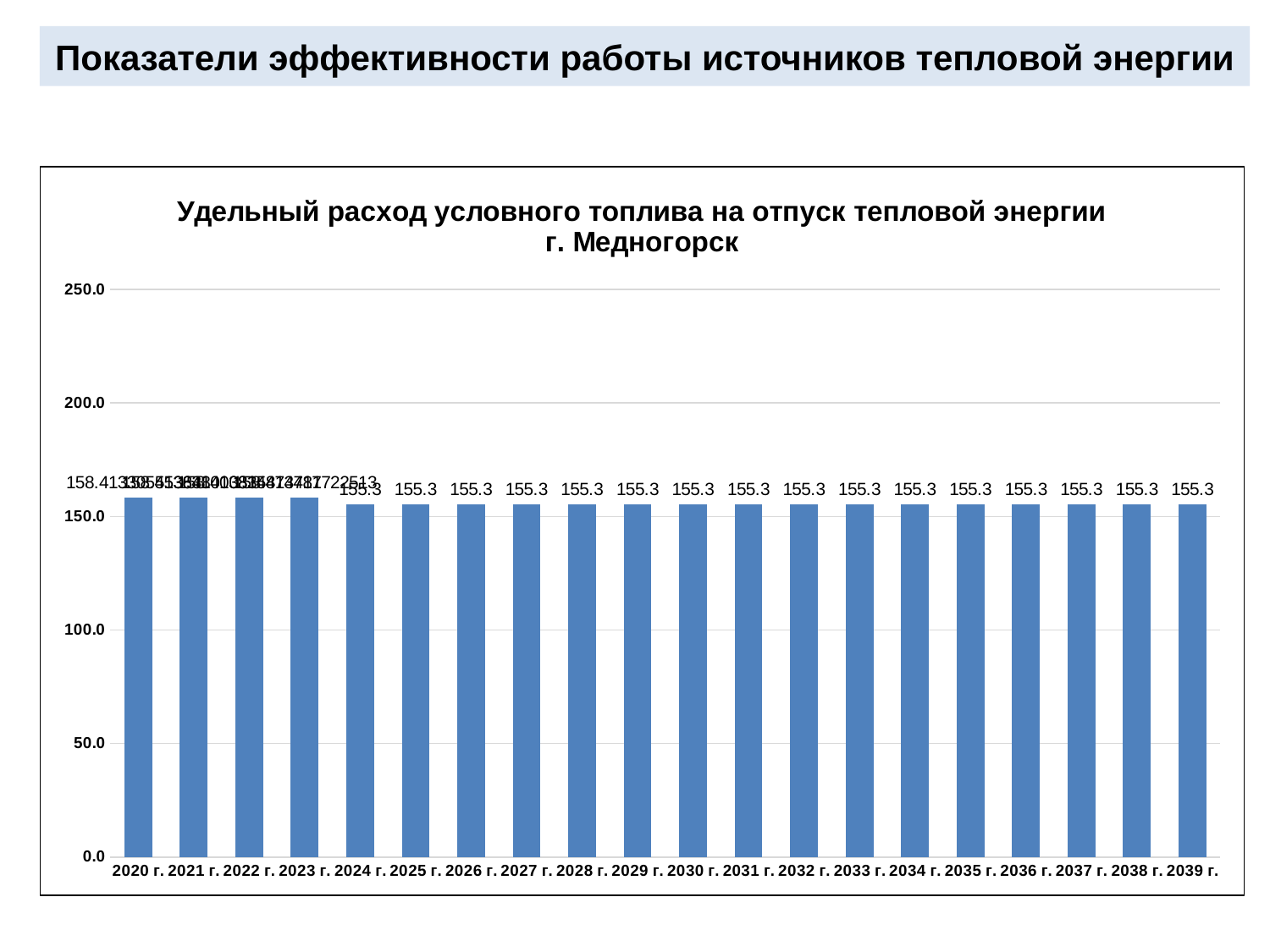
What is the value for 2033 г.? 155.3 Is the value for 2021 г. greater or less than 200? less What is the title of the chart? Удельный расход условного топлива на отпуск тепловой энергии г. Медногорск Do the values change between 2024 г. and 2039 г., or stay the same? stay the same Is the value for 2028 г. greater or less than 100? greater What is the value for 2039 г.? 155.3 What type of chart is shown on the slide? bar chart How many years (categories) are plotted on the x axis? 20 What is the value for 2025 г.? 155.3 What is the value for 2030 г.? 155.3 Is the value for 2035 г. greater or less than 150? greater What is the highest value shown on the y axis? 250.0